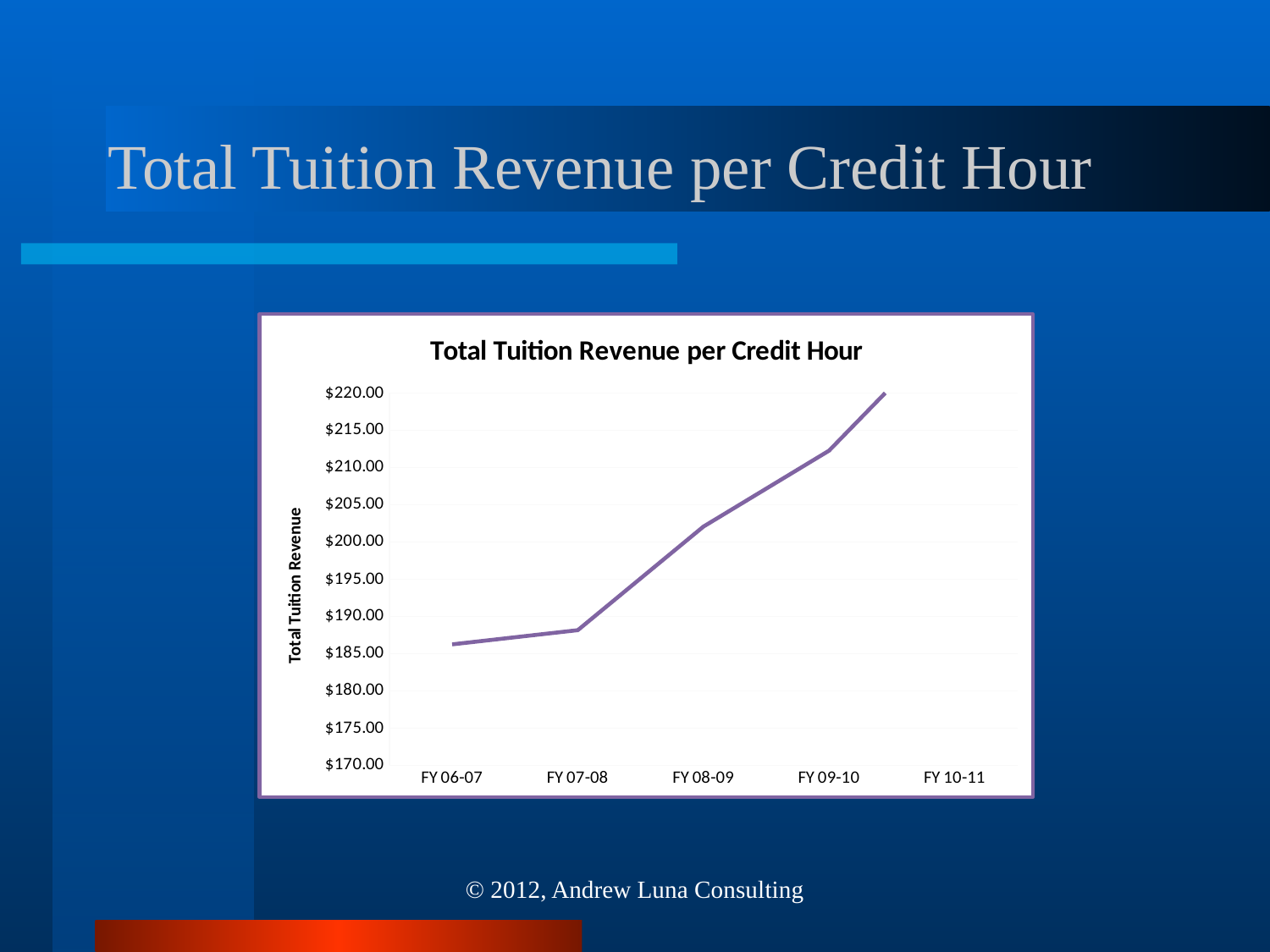
Does total tuition revenue per credit hour rise or fall from FY 06-07 to FY 10-11? rise How many fiscal years are plotted on the x axis? 5 What kind of chart is shown on the slide? line chart What is the label on the vertical axis of the chart? Total Tuition Revenue Which is larger, the value for FY 08-09 or the value for FY 07-08? FY 08-09 Is the value for FY 06-07 greater or less than $190.00? less Which fiscal year has the lowest total tuition revenue per credit hour? FY 06-07 What is the title of the chart? Total Tuition Revenue per Credit Hour Is the value for FY 07-08 greater or less than $195.00? less Is the value for FY 09-10 greater or less than $210.00? greater Which fiscal year has the highest total tuition revenue per credit hour? FY 10-11